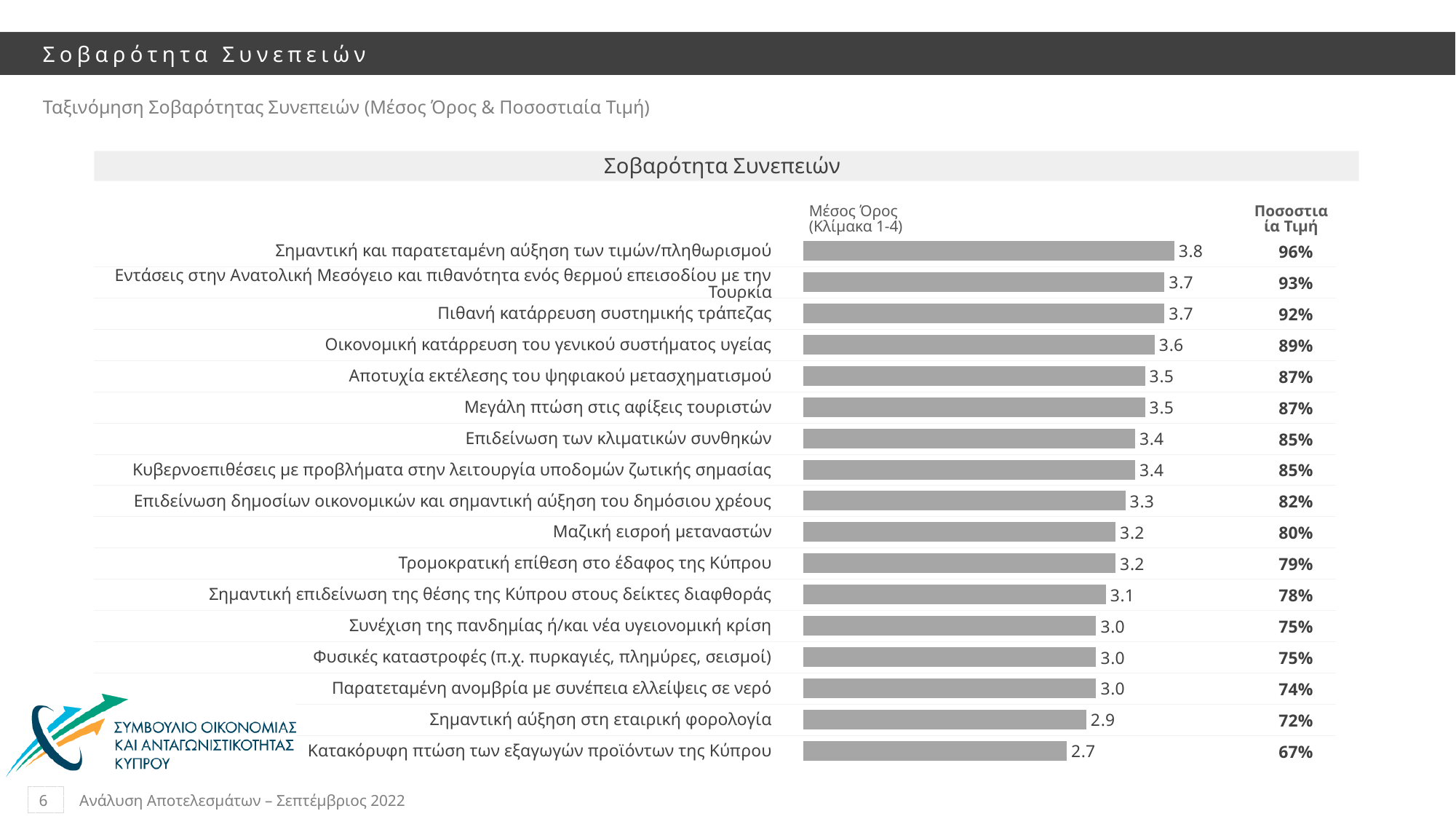
What is the difference in percentage value between 'Οικονομική κατάρρευση του γενικού συστήματος υγείας' and 'Συνέχιση της πανδημίας ή/και νέα υγειονομική κρίση'? 14% What percentage value (Ποσοστιαία Τιμή) is shown for 'Επιδείνωση των κλιματικών συνθηκών'? 85% Which category has the lowest mean score? Κατακόρυφη πτώση των εξαγωγών προϊόντων της Κύπρου What is the difference in mean score between 'Σημαντική και παρατεταμένη αύξηση των τιμών/πληθωρισμού' and 'Κατακόρυφη πτώση των εξαγωγών προϊόντων της Κύπρου'? 1.1 What percentage value is shown for 'Σημαντική αύξηση στη εταιρική φορολογία'? 72% How many categories are shown in the chart? 17 Which category has the highest mean score? Σημαντική και παρατεταμένη αύξηση των τιμών/πληθωρισμού Which has a higher mean score: 'Τρομοκρατική επίθεση στο έδαφος της Κύπρου' or 'Αποτυχία εκτέλεσης του ψηφιακού μετασχηματισμού'? Αποτυχία εκτέλεσης του ψηφιακού μετασχηματισμού What is the mean score for 'Πιθανή κατάρρευση συστημικής τράπεζας'? 3.7 What is the mean score (Μέσος Όρος) for 'Μαζική εισροή μεταναστών'? 3.2 What type of chart is shown on the slide? Bar chart What is the title of the chart? Σοβαρότητα Συνεπειών